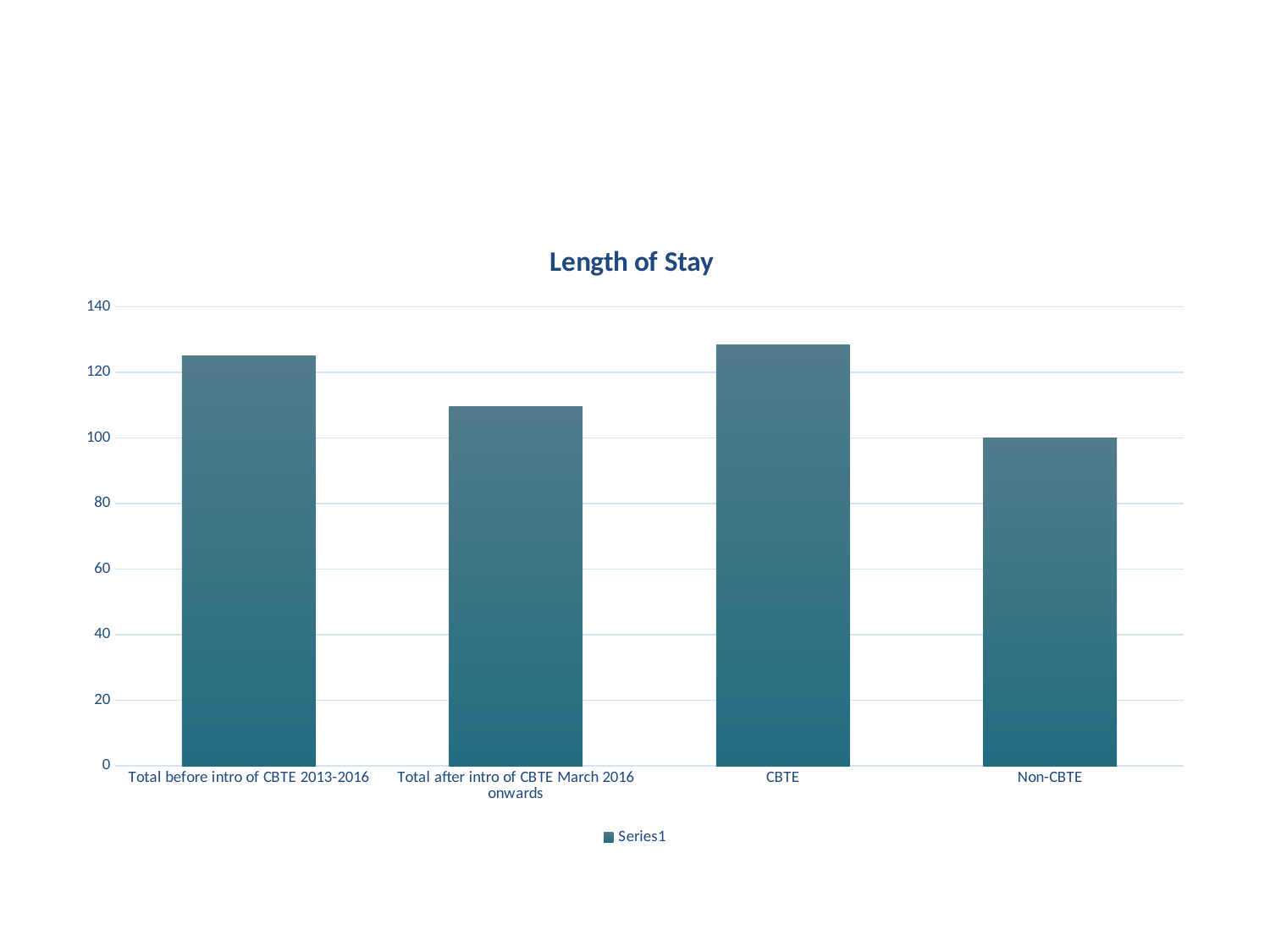
How many categories are plotted in the chart? 4 Which is larger, the value for CBTE or the value for Non-CBTE? CBTE Which is larger, the value for 'Total before intro of CBTE 2013-2016' or the value for 'Total after intro of CBTE March 2016 onwards'? Total before intro of CBTE 2013-2016 Is the value for Non-CBTE greater or less than 120? less How many series does the legend list? 1 Is the value for CBTE greater or less than 120? greater Which category has the lowest value? Non-CBTE Is the value for 'Total before intro of CBTE 2013-2016' greater or less than 120? greater What is the title of the chart? Length of Stay What kind of chart is shown on the slide? bar chart What is the name of the series shown in the legend? Series1